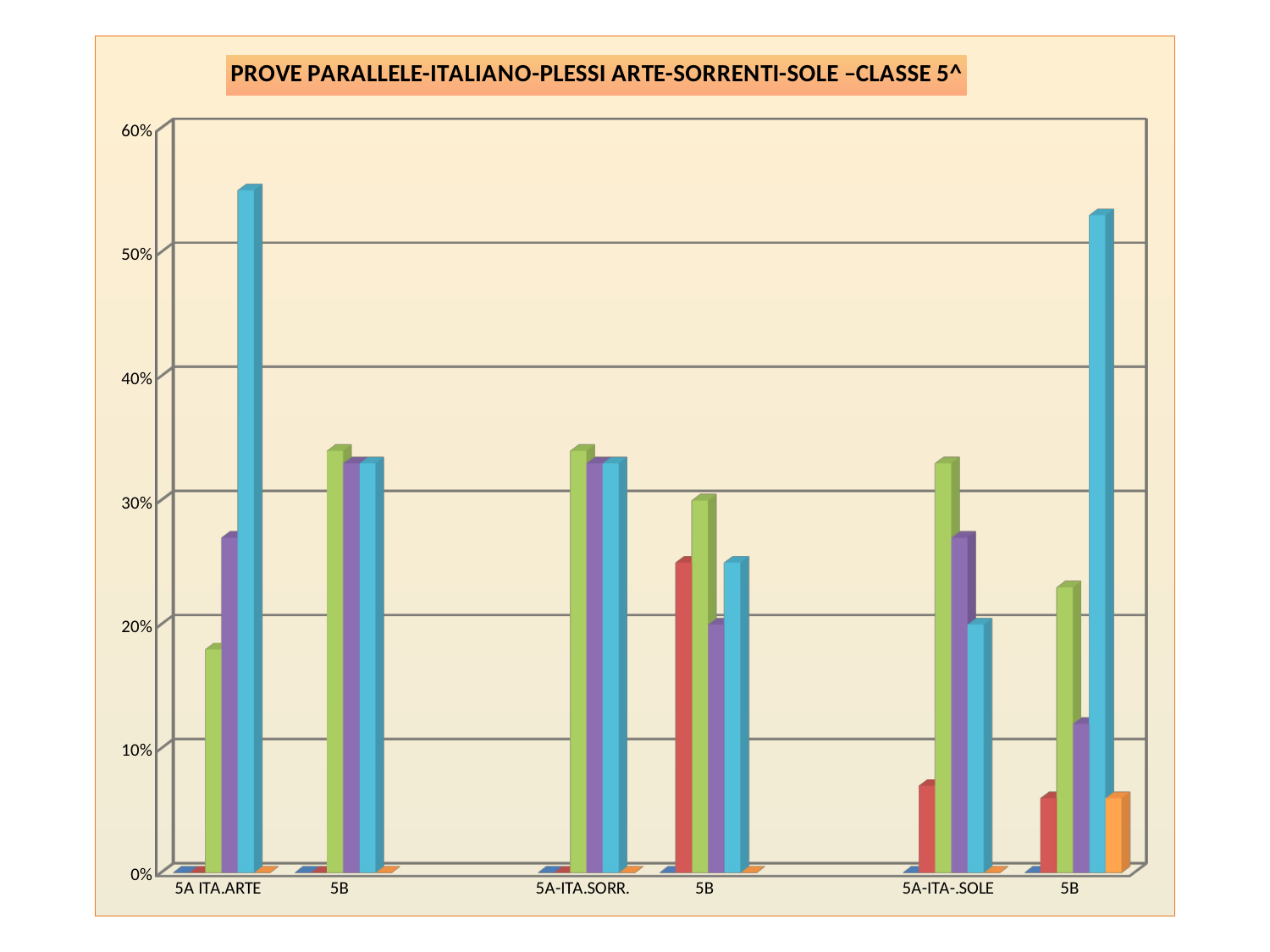
Is the value of the light blue bar for 5A ITA.ARTE greater or less than 50%? greater Which is larger: the red bar in the middle 5B group (next to 5A-ITA.SORR.) or the red bar in the last 5B group (next to 5A-ITA-.SOLE)? the red bar in the middle 5B group What is the title of the chart? PROVE PARALLELE-ITALIANO-PLESSI ARTE-SORRENTI-SOLE –CLASSE 5^ How many category groups are shown along the x axis? 6 What kind of chart is shown on the slide? bar chart Is the value of the light blue bar for the last 5B group (next to 5A-ITA-.SOLE) greater or less than 50%? greater Is the value of the red bar for 5A-ITA-.SOLE greater or less than 10%? less For 5A ITA.ARTE, which is larger: the light blue bar or the green bar? the light blue bar